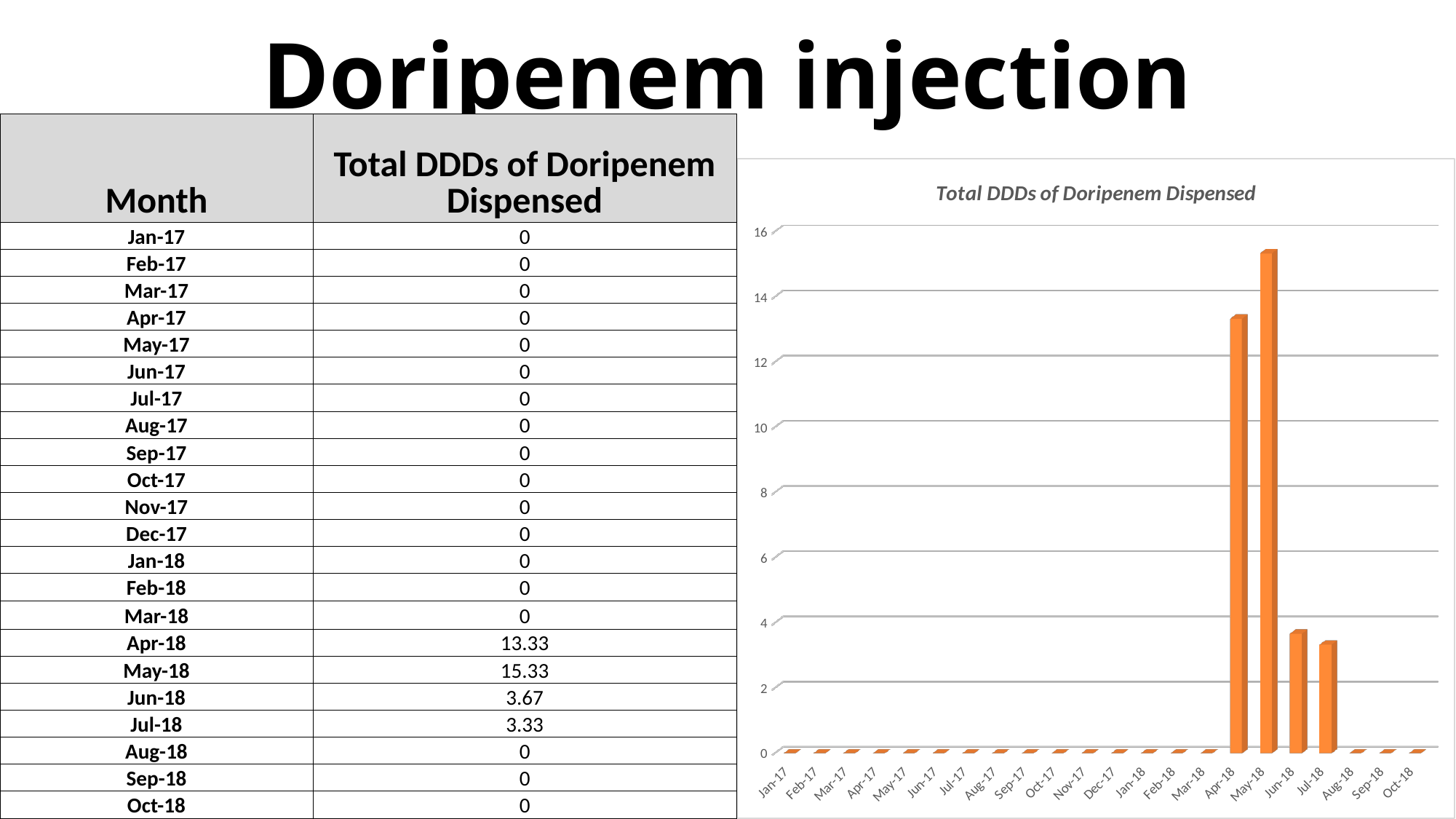
What is the difference between the total DDDs dispensed in May-18 and Apr-18? 2 What is the title of the chart? Total DDDs of Doripenem Dispensed Is the value for Apr-18 greater or less than 12? greater Which month has the highest total DDDs of Doripenem dispensed? May-18 How many months are plotted along the x axis of the chart? 22 What is the total DDDs of Doripenem dispensed in Dec-17? 0 What is the total DDDs of Doripenem dispensed in Jun-18? 3.67 What is the total DDDs of Doripenem dispensed in May-18? 15.33 What type of chart is shown on the slide? bar chart What is the total DDDs of Doripenem dispensed in Jul-18? 3.33 Which is larger, the value for Jun-18 or the value for Jul-18? Jun-18 What is the total DDDs of Doripenem dispensed in Apr-18? 13.33